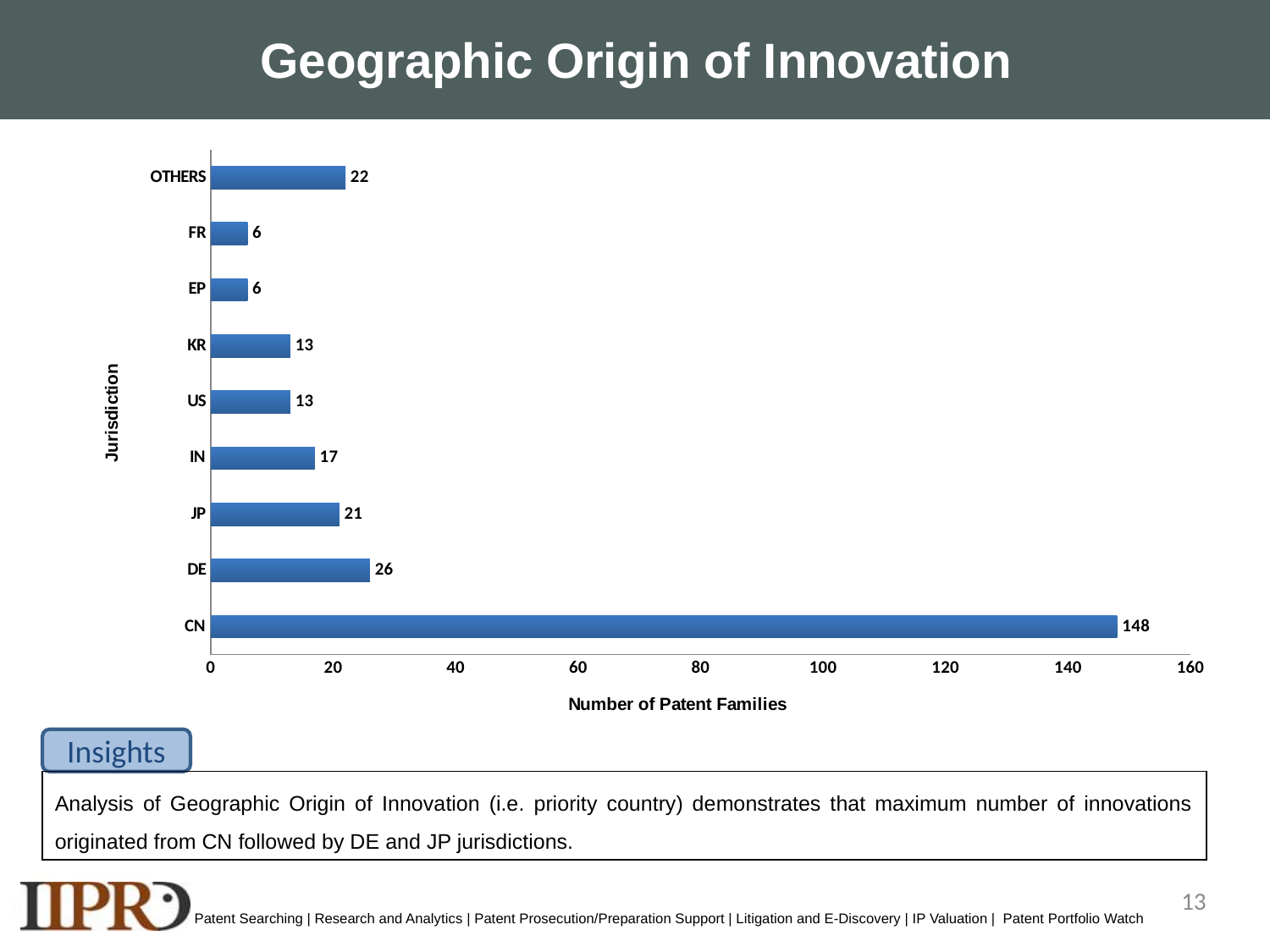
What is the label of the vertical axis? Jurisdiction Is the value for CN greater or less than 140? greater What is the difference in number of patent families between JP and IN? 4 How many jurisdictions are shown on the chart? 9 What is the label of the horizontal axis? Number of Patent Families Which has more patent families, DE or JP? DE Which jurisdiction has the highest number of patent families? CN What is the number of patent families for CN? 148 What is the number of patent families for DE? 26 What is the number of patent families for OTHERS? 22 What is the difference in number of patent families between CN and DE? 122 What kind of chart is shown on the slide? Bar chart